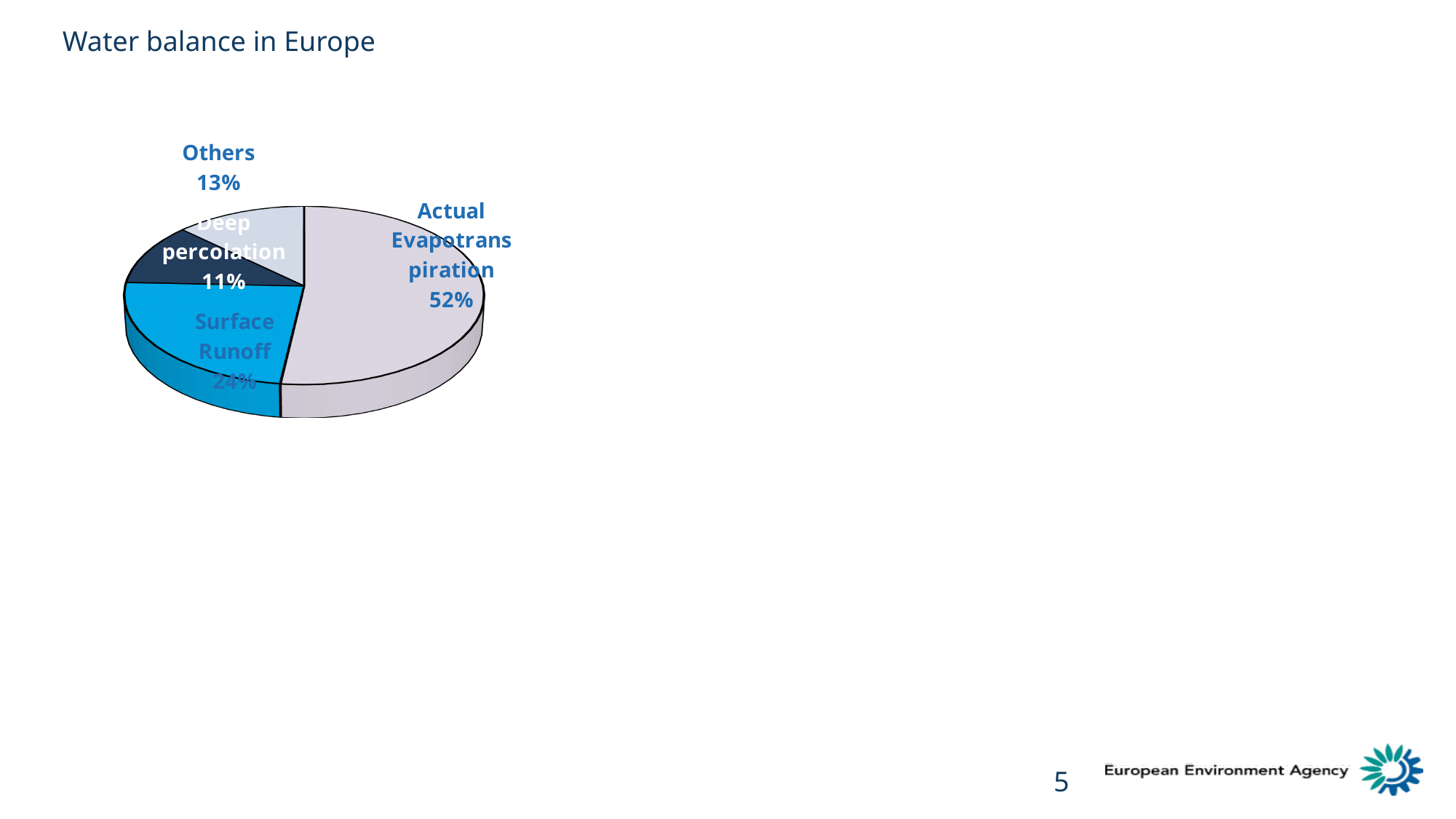
How many slices does the pie chart have? 4 What share of the pie does Others account for? 13% What is the title of the slide containing the chart? Water balance in Europe What share of the pie does Surface Runoff account for? 24% What share of the pie does Actual Evapotranspiration account for? 52% Which category has the smallest share of the pie? Deep percolation What is the difference in percentage points between Actual Evapotranspiration and Surface Runoff? 28 What kind of chart is shown on the slide? Pie chart What is the difference in percentage points between Others and Deep percolation? 2 Which is larger, Surface Runoff or Others? Surface Runoff Which category has the largest share of the pie? Actual Evapotranspiration